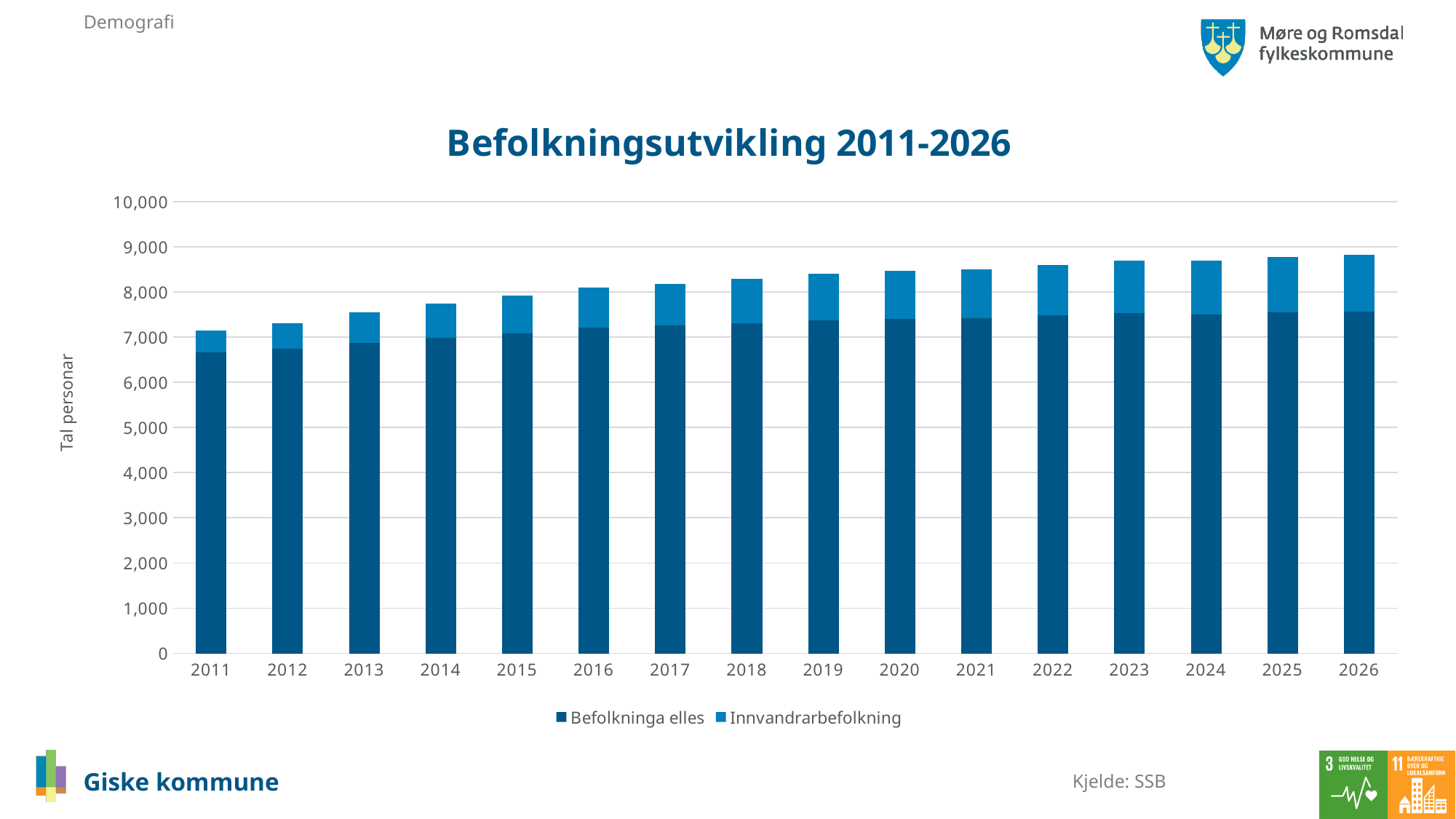
Is the total bar for 2020 greater or less than 8,000? greater What kind of chart is shown on the slide? Stacked bar chart What is the label on the y axis? Tal personar Do the total bar heights rise or fall from 2011 to 2026? Rise How many series does the legend list? 2 Is the total bar for 2026 greater or less than 9,000? less How many years are shown on the x axis? 16 Which year has the highest total population bar? 2026 What is the title of the chart? Befolkningsutvikling 2011-2026 Is the 'Befolkninga elles' segment for 2011 greater or less than 7,000? less Which year has the lowest total population bar? 2011